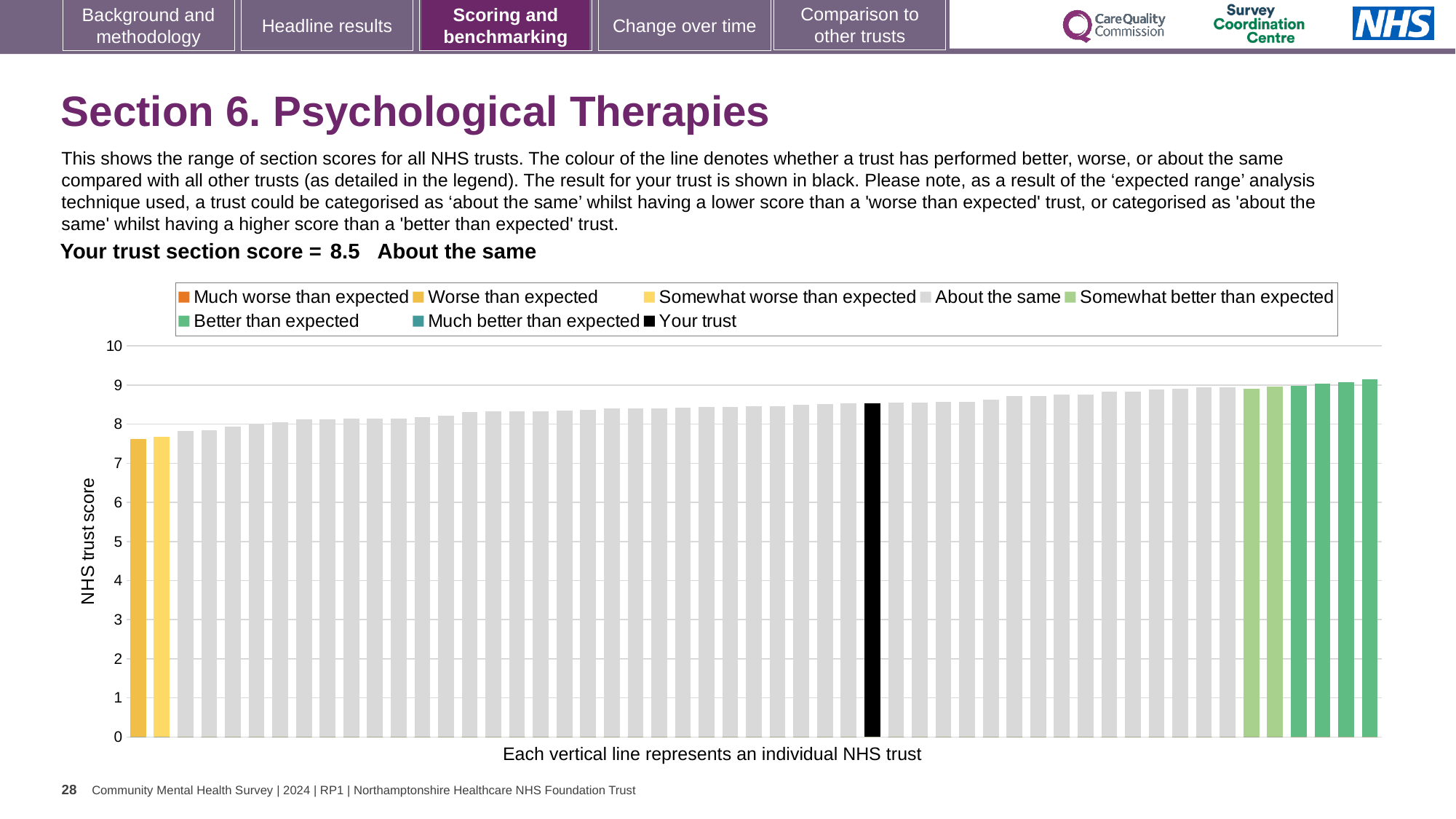
Do the bar values rise or fall from left to right across the chart? Rise What kind of chart is used to show the NHS trust scores? Bar chart Is the value of the leftmost bar greater or less than 8? less Is the highest bar on the chart greater or less than 10? less How many entries does the chart legend list? 8 Is the value of the leftmost bar greater or less than 7? greater Where is the lowest-scoring trust's bar positioned on the chart, at the far left or the far right? Far left What colour is used for the bar representing your trust? Black Which performance category is the trust's section score placed in? About the same What is the trust's section score for Psychological Therapies shown on the slide? 8.5